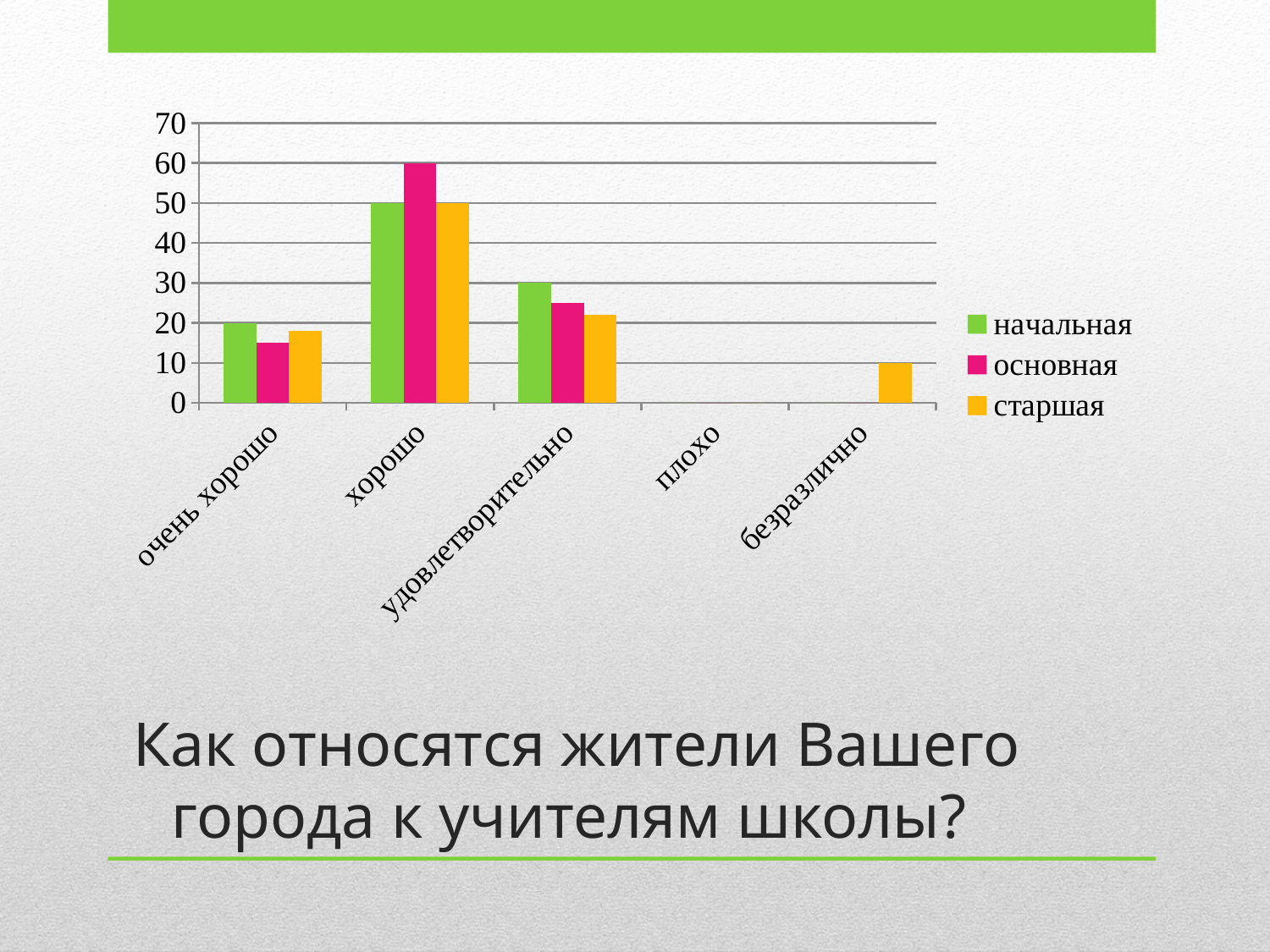
Is the value for основная in the category очень хорошо greater or less than 20? less Which category has the highest value for the основная series? хорошо Is the value for основная in the category удовлетворительно greater or less than 20? greater What kind of chart is shown on the slide? bar chart What is the value for начальная in the category хорошо? 50 In the category хорошо, which series has the larger value, основная or старшая? основная How many categories are shown on the x axis? 5 How many series does the legend list? 3 What is the value for старшая in the category безразлично? 10 What is the value for начальная in the category удовлетворительно? 30 What is the difference between the начальная value for хорошо and the начальная value for очень хорошо? 30 What is the value for основная in the category хорошо? 60